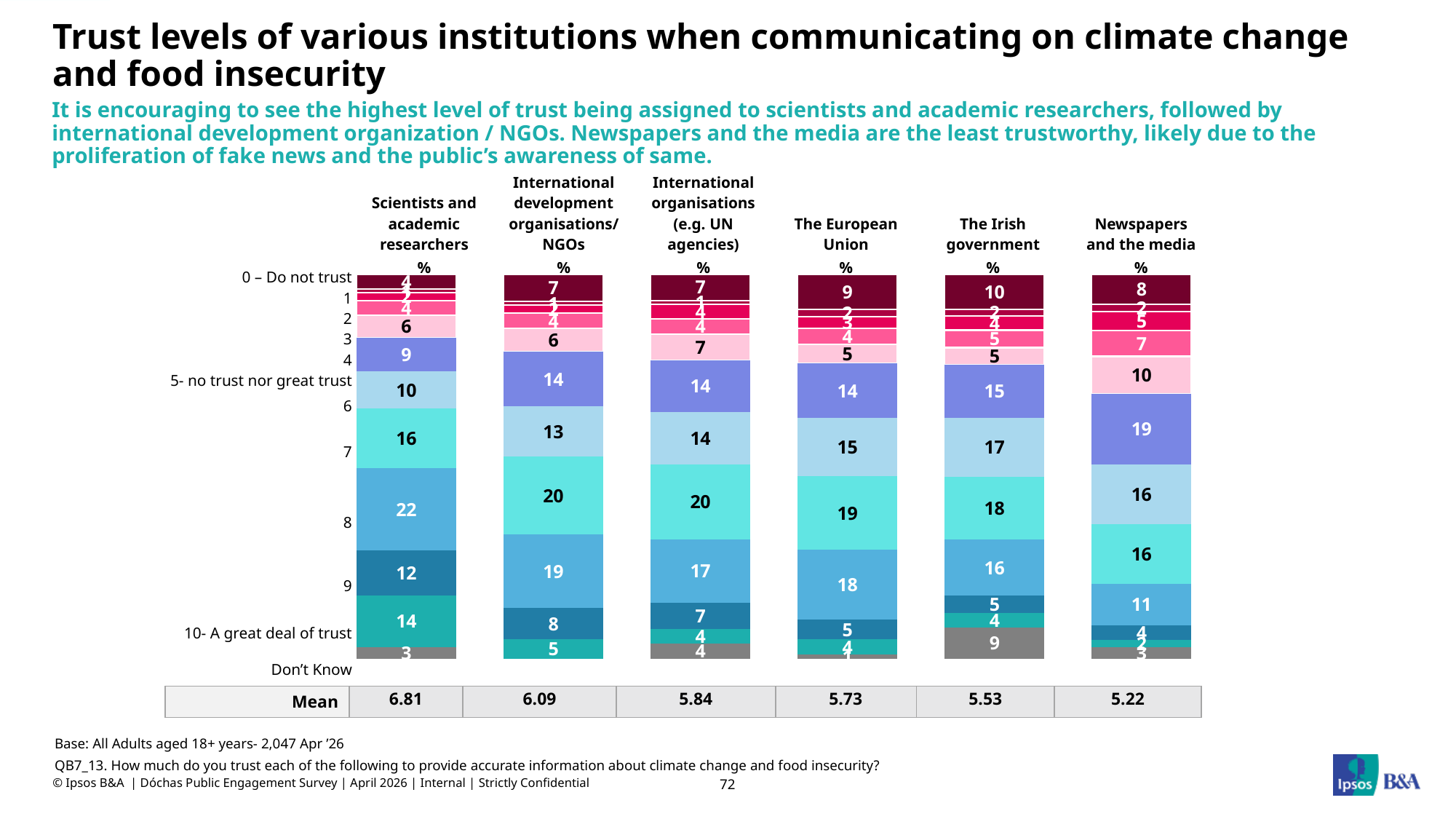
What is the mean trust score for Newspapers and the media? 5.22 Which institution has the highest share of '0 – Do not trust' responses? The Irish government Which has a higher mean trust score, The Irish government or International organisations (e.g. UN agencies)? International organisations (e.g. UN agencies) What is the mean trust score for Scientists and academic researchers? 6.81 What type of chart is used on this slide? Stacked bar chart Which institution has the lowest mean trust score? Newspapers and the media What is the difference between the mean scores for Scientists and academic researchers and Newspapers and the media? 1.59 What percentage of respondents gave a '0 – Do not trust' rating to Scientists and academic researchers? 4% What percentage of respondents gave a '0 – Do not trust' rating to The Irish government? 10% What is the mean trust score for The European Union? 5.73 How many institutions are shown as bars in the chart? 6 Which institution has the highest mean trust score? Scientists and academic researchers